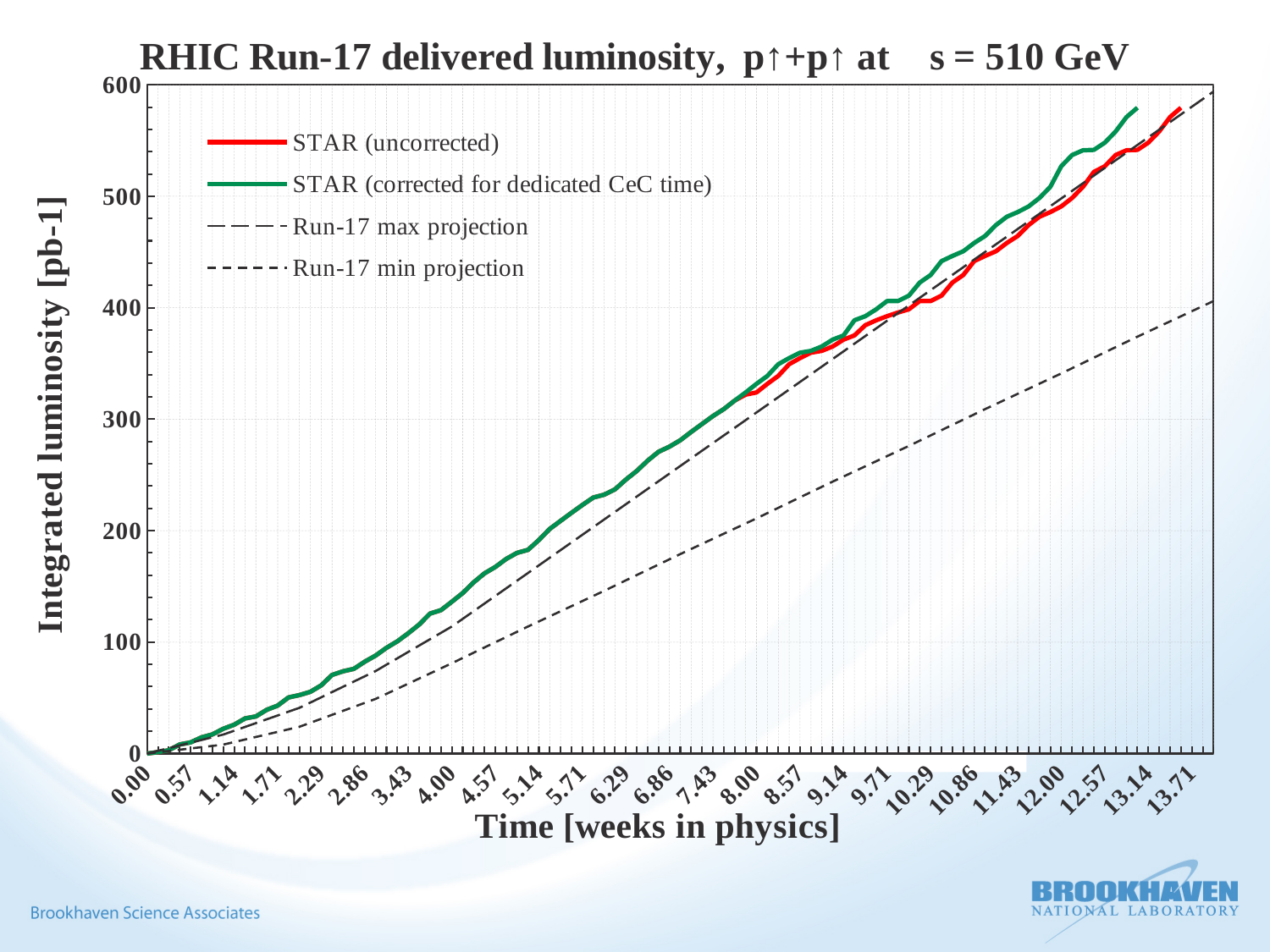
Is the value of the Run-17 max projection at 13.71 weeks greater or less than 500? greater Do the STAR (corrected for dedicated CeC time) values rise or fall as time increases? rise What is the title of the chart? RHIC Run-17 delivered luminosity, p↑+p↑ at s = 510 GeV Is the value of the Run-17 min projection at 13.71 weeks greater or less than 500? less What kind of chart is shown on the slide? line chart At 13.14 weeks, which is larger: STAR (uncorrected) or STAR (corrected for dedicated CeC time)? STAR (corrected for dedicated CeC time) Is the value of STAR (uncorrected) at 8.00 weeks greater or less than 400? less How many series does the legend list? 4 At 8.00 weeks, which is larger: STAR (corrected for dedicated CeC time) or Run-17 min projection? STAR (corrected for dedicated CeC time) Which series has the lowest value at the right end of the chart? Run-17 min projection What is the label of the y axis? Integrated luminosity [pb-1]